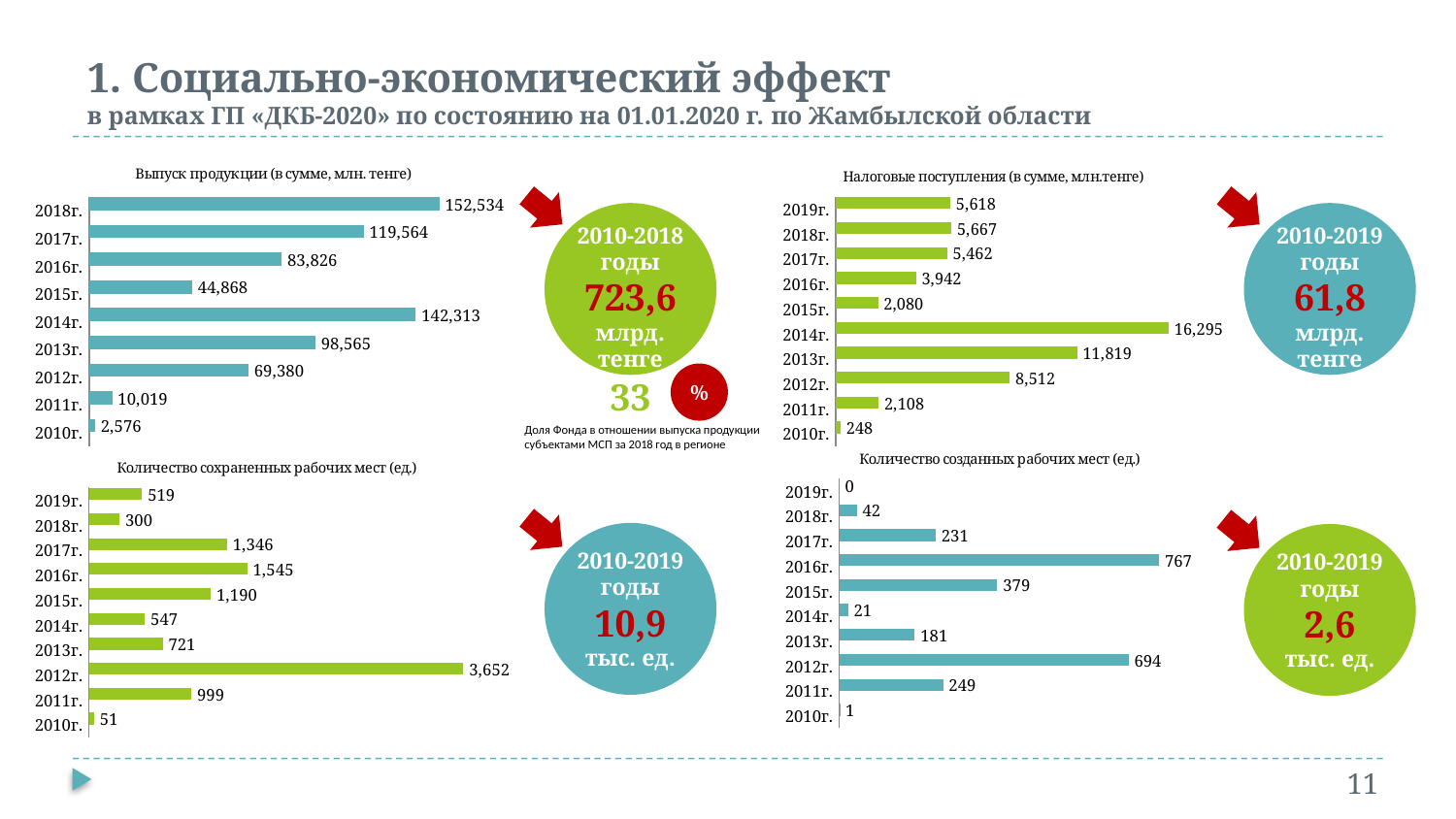
In the chart titled "Выпуск продукции (в сумме, млн. тенге)", what is the difference between the values for 2018г. and 2017г.? 32,970 In the chart titled "Выпуск продукции (в сумме, млн. тенге)", which year has the lowest value? 2010г. In the chart titled "Налоговые поступления (в сумме, млн.тенге)", what is the value for 2013г.? 11,819 In the chart titled "Налоговые поступления (в сумме, млн.тенге)", how many years are shown? 10 In the chart titled "Количество созданных рабочих мест (ед.)", what is the value for 2016г.? 767 In the chart titled "Количество созданных рабочих мест (ед.)", which year has the lowest value? 2019г. In the chart titled "Количество сохраненных рабочих мест (ед.)", which is larger, the value for 2016г. or the value for 2017г.? 2016г. What kind of chart is the chart titled "Выпуск продукции (в сумме, млн. тенге)"? Bar chart In the chart titled "Количество сохраненных рабочих мест (ед.)", what is the value for 2012г.? 3,652 In the chart titled "Налоговые поступления (в сумме, млн.тенге)", which year has the highest value? 2014г. In the chart titled "Выпуск продукции (в сумме, млн. тенге)", what is the value for 2018г.? 152,534 In the chart titled "Количество сохраненных рабочих мест (ед.)", what is the difference between the values for 2011г. and 2010г.? 948